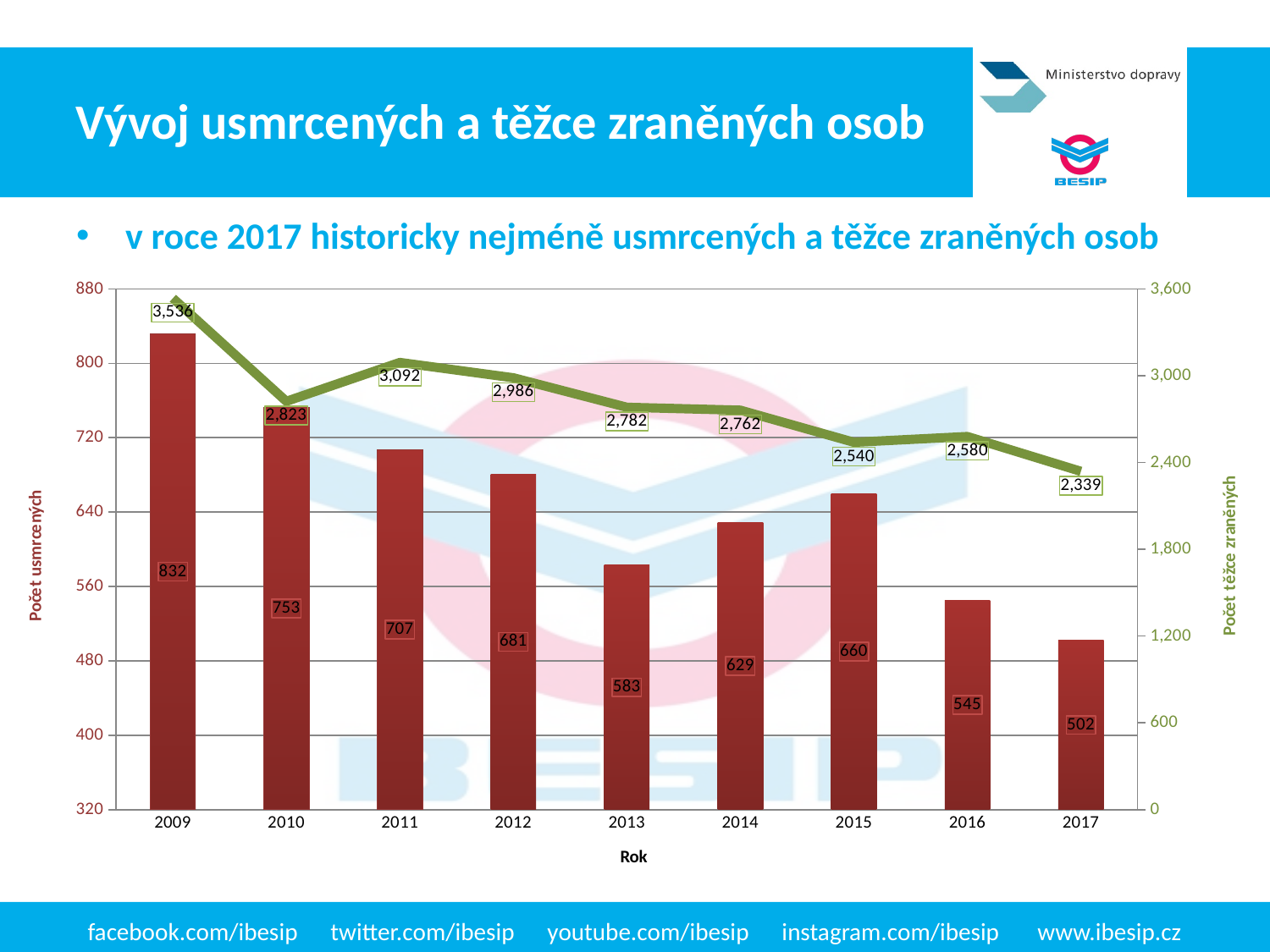
What kind of chart is shown on the slide? Combined bar and line chart What is the value of Počet těžce zraněných for 2011? 3,092 How many years are shown on the x axis? 9 Which year has the lowest value of Počet usmrcených? 2017 What is the title of the x axis? Rok What is the value of Počet těžce zraněných (the line) for 2017? 2,339 What is the difference between Počet usmrcených in 2009 and in 2017? 330 What is the value of Počet usmrcených for 2013? 583 What is the value of Počet usmrcených (the bars) for 2009? 832 Which year has the highest value of Počet těžce zraněných? 2009 What is the difference between Počet těžce zraněných in 2015 and in 2016? 40 Which is larger, Počet usmrcených in 2014 or in 2015? 2015